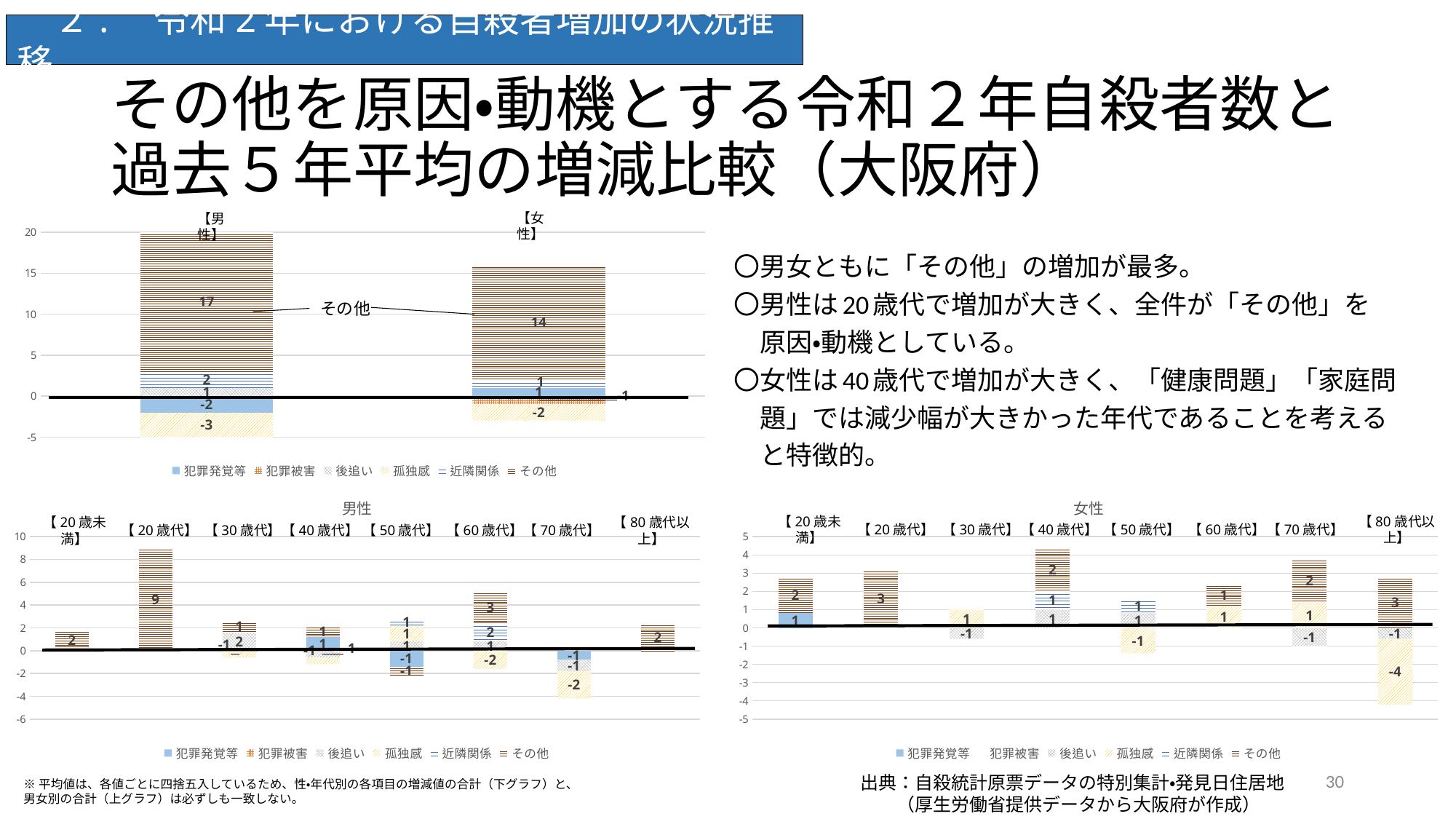
In the top chart, what is the value of 孤独感 for 男性? -3 In the bottom-right 女性 chart, what is the value of その他 for 20歳代? 3 In the top chart, what is the value of その他 for 女性? 14 In the top chart, which has the larger その他 value, 男性 or 女性? 男性 How many series does the legend of the top chart list? 6 In the bottom-left 男性 chart, which age group has the highest その他 value? 20歳代 In the bottom-right 女性 chart, what is the value of 孤独感 for 80歳代以上? -4 In the bottom-left 男性 chart, what is the value of その他 for 20歳代? 9 How many age categories are shown in the bottom-left 男性 chart? 8 In the top chart, what is the value of その他 for 男性? 17 What kind of chart is the bottom-right 女性 chart? bar chart In the top chart, what is the difference between the その他 values for 男性 and 女性? 3